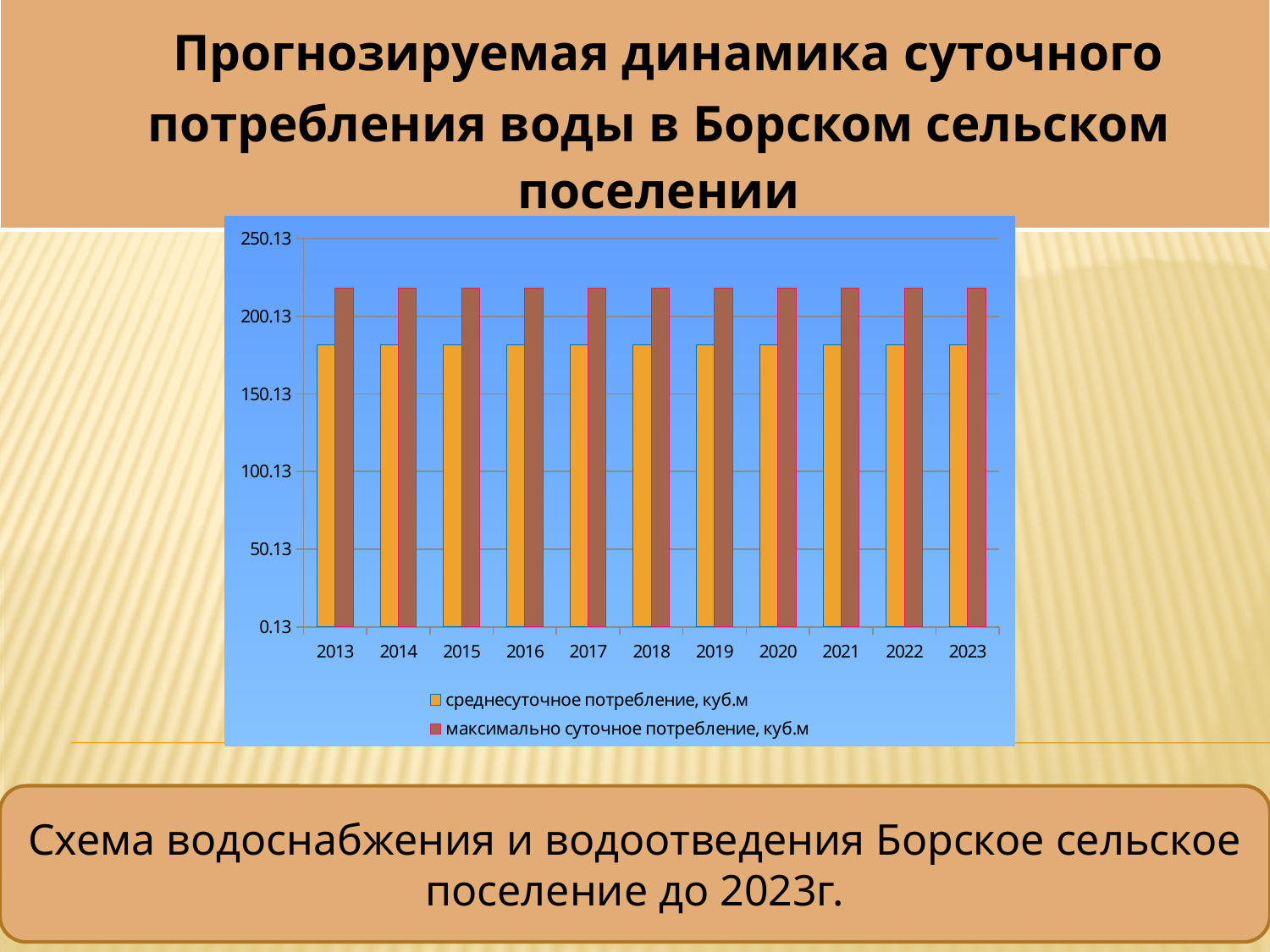
Do the values for максимально суточное потребление rise, fall, or stay the same across the years shown? stay the same How many series does the chart legend list? 2 Is the value for максимально суточное потребление in 2018 greater or less than 200.13? greater What is the first year shown on the x axis of the chart? 2013 What kind of chart is shown on the slide? bar chart Is the value for среднесуточное потребление in 2013 greater or less than 150.13? greater Is the value for максимально суточное потребление in 2020 greater or less than 250.13? less How many years are shown on the x axis of the chart? 11 Do the values for среднесуточное потребление rise, fall, or stay the same from 2013 to 2023? stay the same Which series is larger in 2013: среднесуточное потребление or максимально суточное потребление? максимально суточное потребление, куб.м Which series is shown in orange in the chart legend? среднесуточное потребление, куб.м